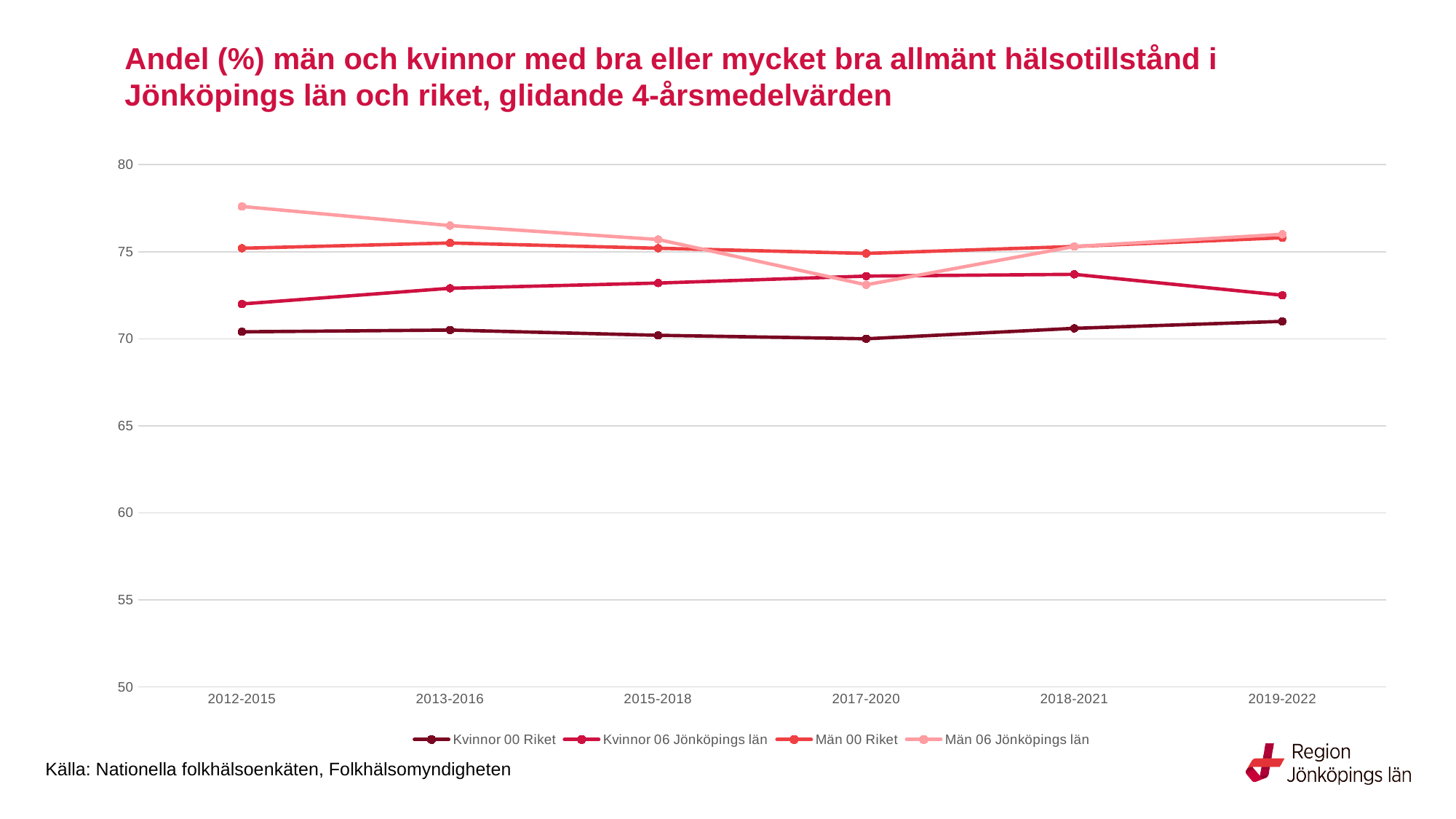
Is the value for Män 06 Jönköpings län in 2012-2015 greater or less than 75? greater In which period does Män 06 Jönköpings län reach its lowest value? 2017-2020 What source is cited below the chart? Nationella folkhälsoenkäten, Folkhälsomyndigheten Which series has the lowest value in 2019-2022? Kvinnor 00 Riket Which series has the highest value in 2012-2015? Män 06 Jönköpings län How many series does the legend list? 4 How many time periods are shown on the x axis? 6 Is the value for Kvinnor 00 Riket in 2017-2020 greater or less than 75? less What kind of chart is shown on the slide? line chart Does the Män 06 Jönköpings län line rise or fall from 2012-2015 to 2017-2020? fall Is the value for Kvinnor 06 Jönköpings län in 2012-2015 greater or less than 70? greater In 2017-2020, which is larger: Män 00 Riket or Män 06 Jönköpings län? Män 00 Riket